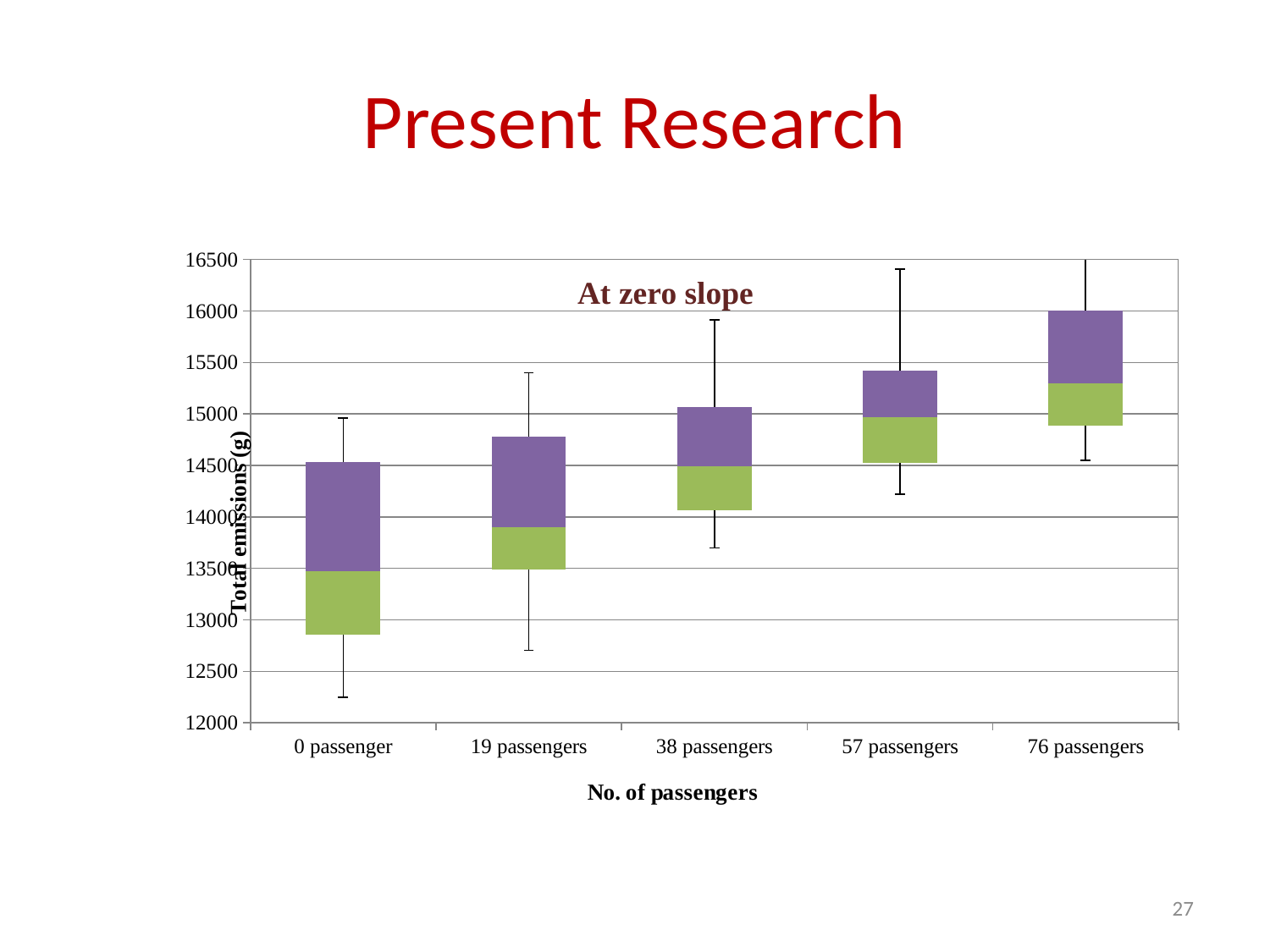
What is the label of the y axis? Total emissions (g) Is the top of the box for 19 passengers greater or less than 15000? less What kind of chart is shown on the slide? Box plot (box-and-whisker chart) Is the bottom of the box for 0 passenger greater or less than 13000? less Is the upper whisker for 57 passengers greater or less than 16000? greater What is the title shown inside the chart? At zero slope Which passenger category has the highest box on the chart? 76 passengers How many passenger categories are shown on the x axis? 5 Do total emissions rise or fall as the number of passengers increases? Rise Which passenger category has the lowest box on the chart? 0 passenger